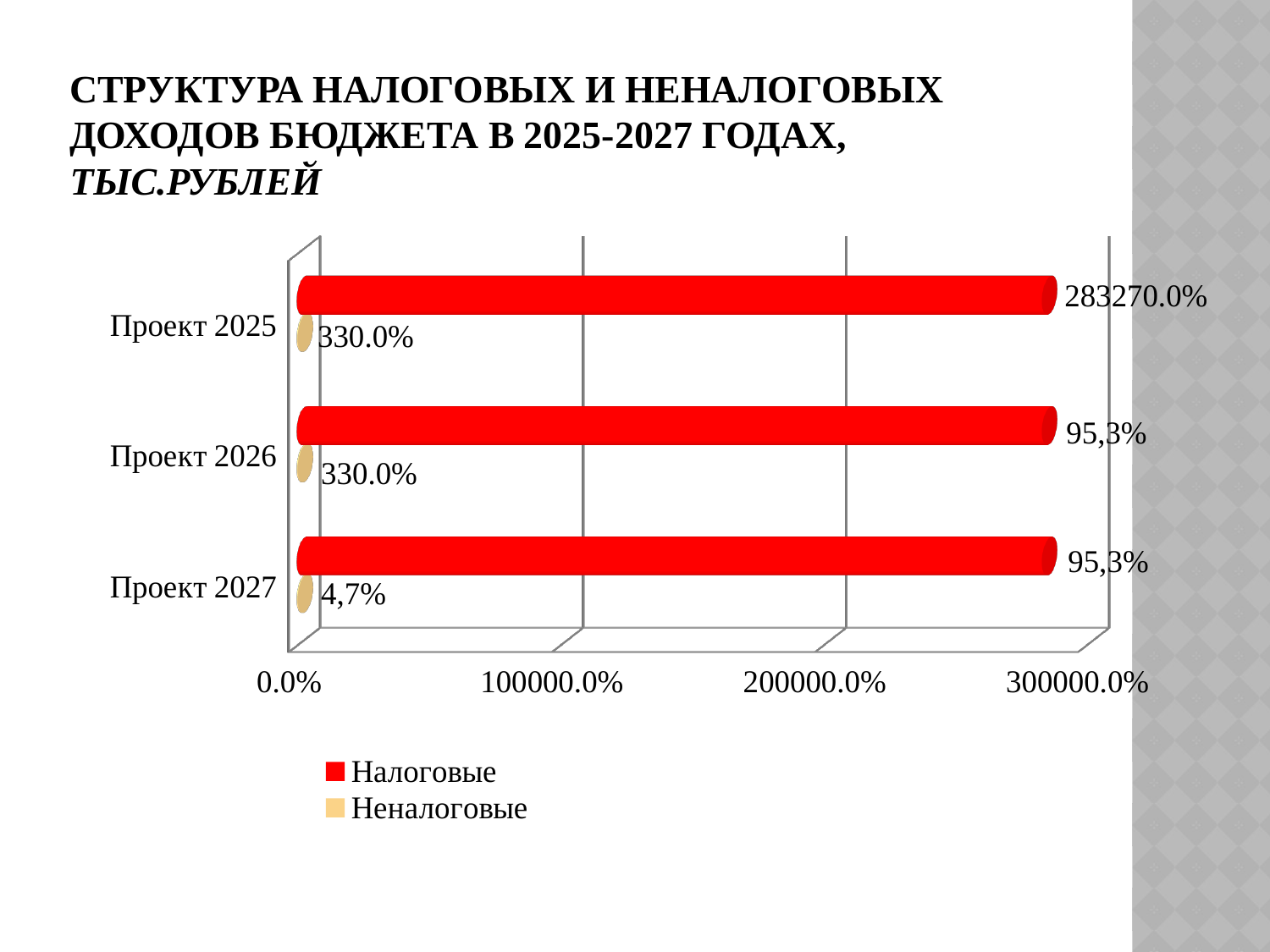
Which series is shown in red in the legend? Налоговые What is the data label for Налоговые for Проект 2025? 283270.0% Is the Налоговые bar for Проект 2025 greater or less than 200000.0% on the axis? greater What is the data label for Налоговые for Проект 2027? 95,3% What is the data label for Налоговые for Проект 2026? 95,3% What type of chart is shown on the slide? bar chart What is the data label for Неналоговые for Проект 2027? 4,7% For Проект 2025, which bar is longer: Налоговые or Неналоговые? Налоговые How many series does the legend list? 2 What is the data label for Неналоговые for Проект 2026? 330.0% What is the data label for Неналоговые for Проект 2025? 330.0% How many categories (projects) are shown on the chart? 3